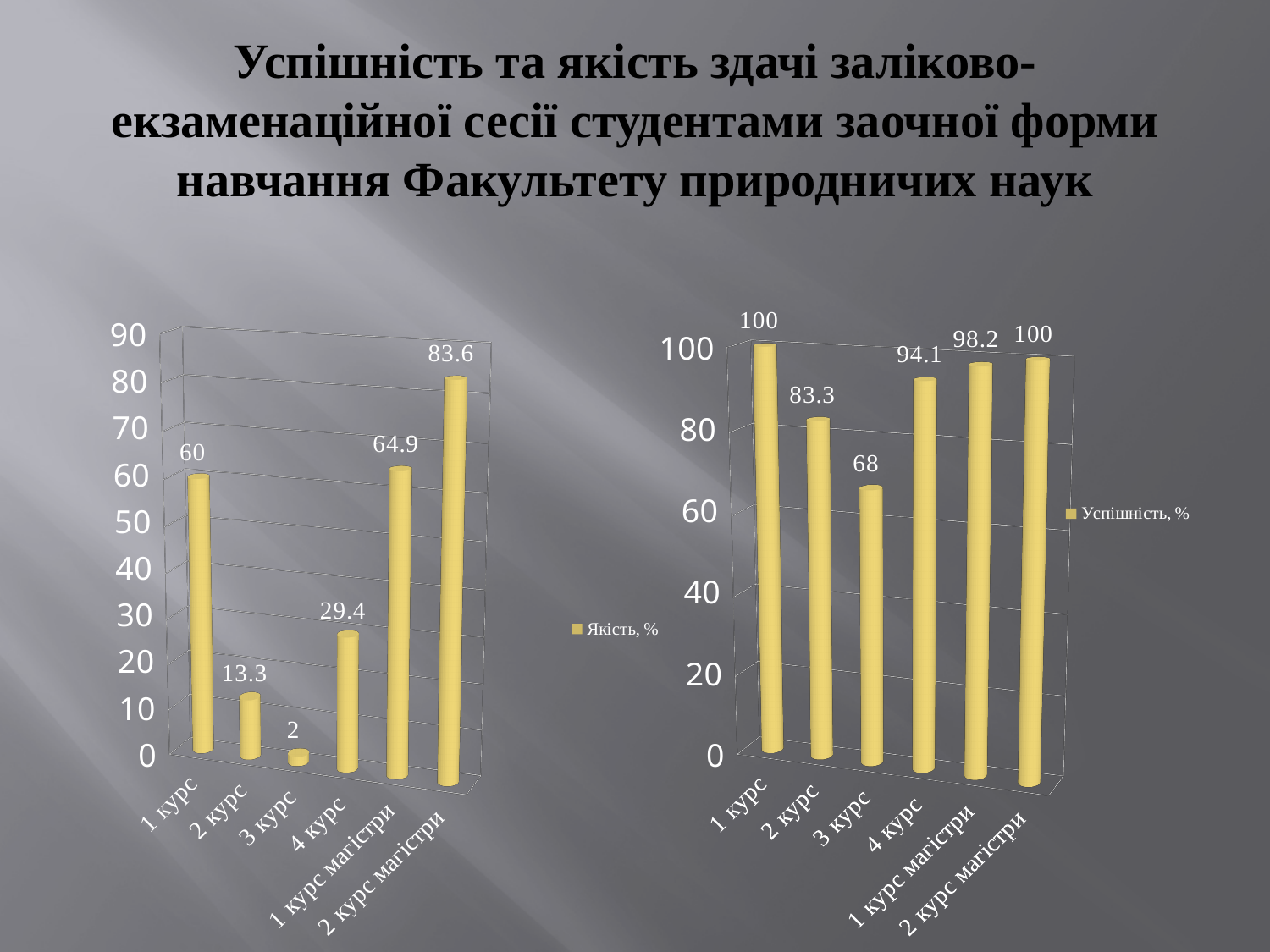
In the right chart (Успішність, %), what is the value for 1 курс магістри? 98.2 In the left chart (Якість, %), which category has the lowest value? 3 курс In the left chart (Якість, %), which category has the highest value? 2 курс магістри In the left chart (Якість, %), what is the difference between the values for 2 курс магістри and 1 курс магістри? 18.7 In the right chart (Успішність, %), which is larger, the value for 2 курс or the value for 4 курс? 4 курс In the left chart (Якість, %), how many categories are shown on the x axis? 6 In the right chart (Успішність, %), what is the value for 3 курс? 68 In the right chart (Успішність, %), which category has the lowest value? 3 курс What is the legend entry of the right chart? Успішність, % In the right chart (Успішність, %), what is the difference between the values for 1 курс and 2 курс? 16.7 In the left chart (Якість, %), what is the value for 2 курс? 13.3 What kind of chart is the left chart? Bar chart